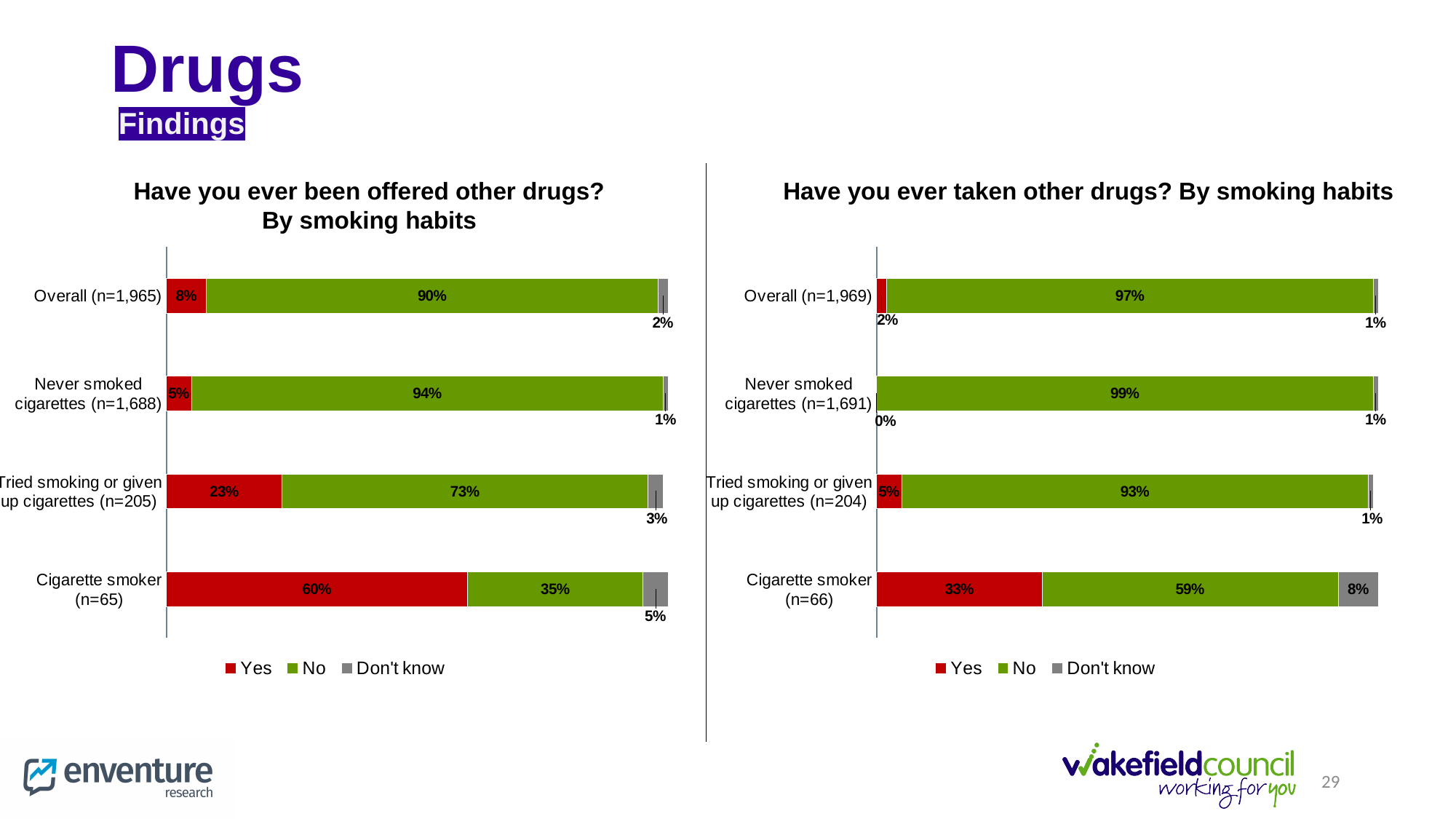
How many series does the legend of the 'Have you ever been offered other drugs?' chart list? 3 In the 'Have you ever taken other drugs?' chart, what is the Don't know value for cigarette smokers (n=66)? 8% In the 'Have you ever been offered other drugs?' chart, what is the difference between the Yes values for cigarette smokers and for those who tried smoking or gave up cigarettes? 37% In the 'Have you ever been offered other drugs?' chart, what is the total of the Yes and No segments for Overall (n=1,965)? 98% Is the Yes value for cigarette smokers larger in the 'offered other drugs' chart or the 'taken other drugs' chart? Offered other drugs chart How many smoking-habit categories are shown in the 'Have you ever taken other drugs?' chart? 4 In the 'Have you ever been offered other drugs?' chart, which category has the highest Yes value? Cigarette smoker (n=65) In the 'Have you ever been offered other drugs?' chart, what is the No value for 'Tried smoking or given up cigarettes (n=205)'? 73% In the 'Have you ever taken other drugs?' chart, what percentage of cigarette smokers (n=66) answered Yes? 33% In the 'Have you ever taken other drugs?' chart, which category has the lowest Yes value? Never smoked cigarettes (n=1,691) What type of chart is the 'Have you ever taken other drugs?' chart? Stacked bar chart In the 'Have you ever been offered other drugs?' chart, what percentage of cigarette smokers (n=65) answered Yes? 60%